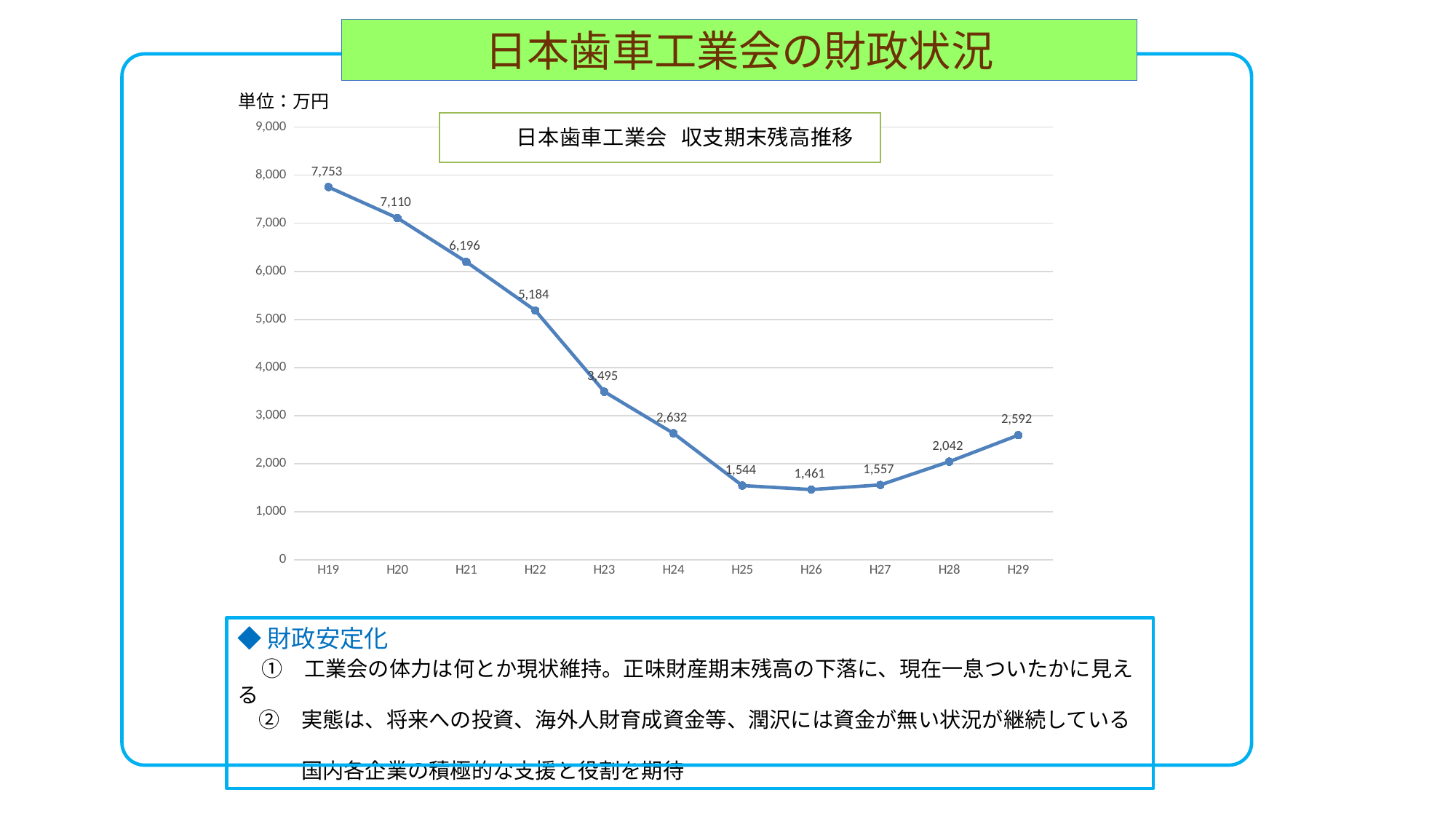
What is the value for H19? 7,753 What is the title of the chart? 日本歯車工業会 収支期末残高推移 What is the value for H29? 2,592 Which year has the highest value? H19 What is the difference between the values for H28 and H29? 550 Which year has the lowest value? H26 What type of chart is shown on the slide? Line chart How many years are plotted on the x axis? 11 What is the value for H23? 3,495 Which is larger, the value for H22 or the value for H24? H22 Does the value rise or fall from H19 to H25? Fall What is the difference between the values for H19 and H20? 643